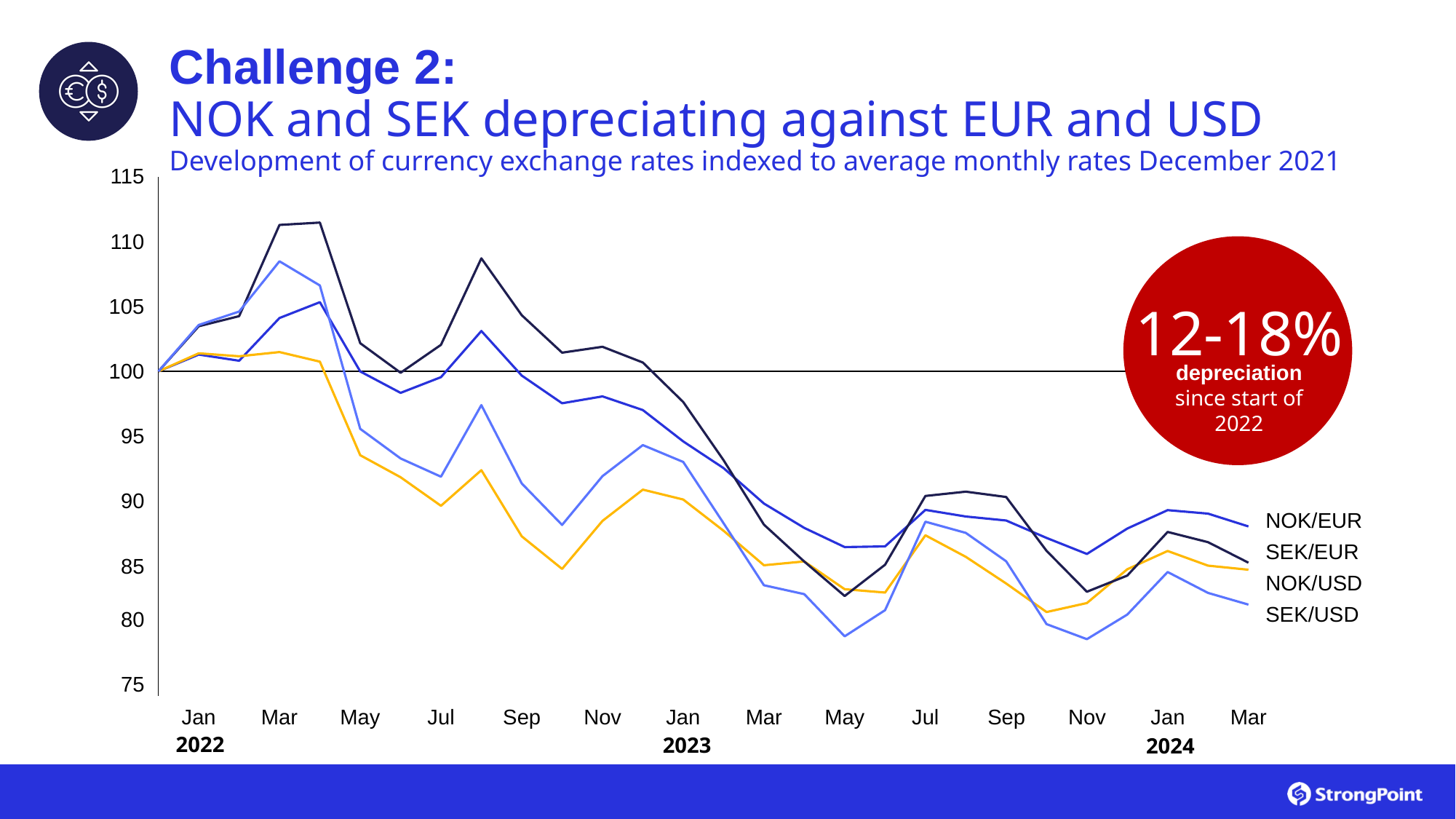
Is the value for NOK/EUR in March 2024 greater or less than 90? less Which series reaches the highest value in March 2022? SEK/EUR Which series has the lowest value in May 2023? SEK/USD How many currency pair series are plotted on the chart? 4 What depreciation range since the start of 2022 is highlighted in the red circle? 12-18% Is the value for SEK/EUR in March 2022 greater or less than 110? greater What is the subtitle describing the chart? Development of currency exchange rates indexed to average monthly rates December 2021 Overall, do the index values rise or fall from January 2022 to March 2024? fall Is the value for SEK/EUR in January 2023 greater or less than 100? less What kind of chart is shown on the slide? line chart In March 2024, which is higher: NOK/EUR or SEK/USD? NOK/EUR